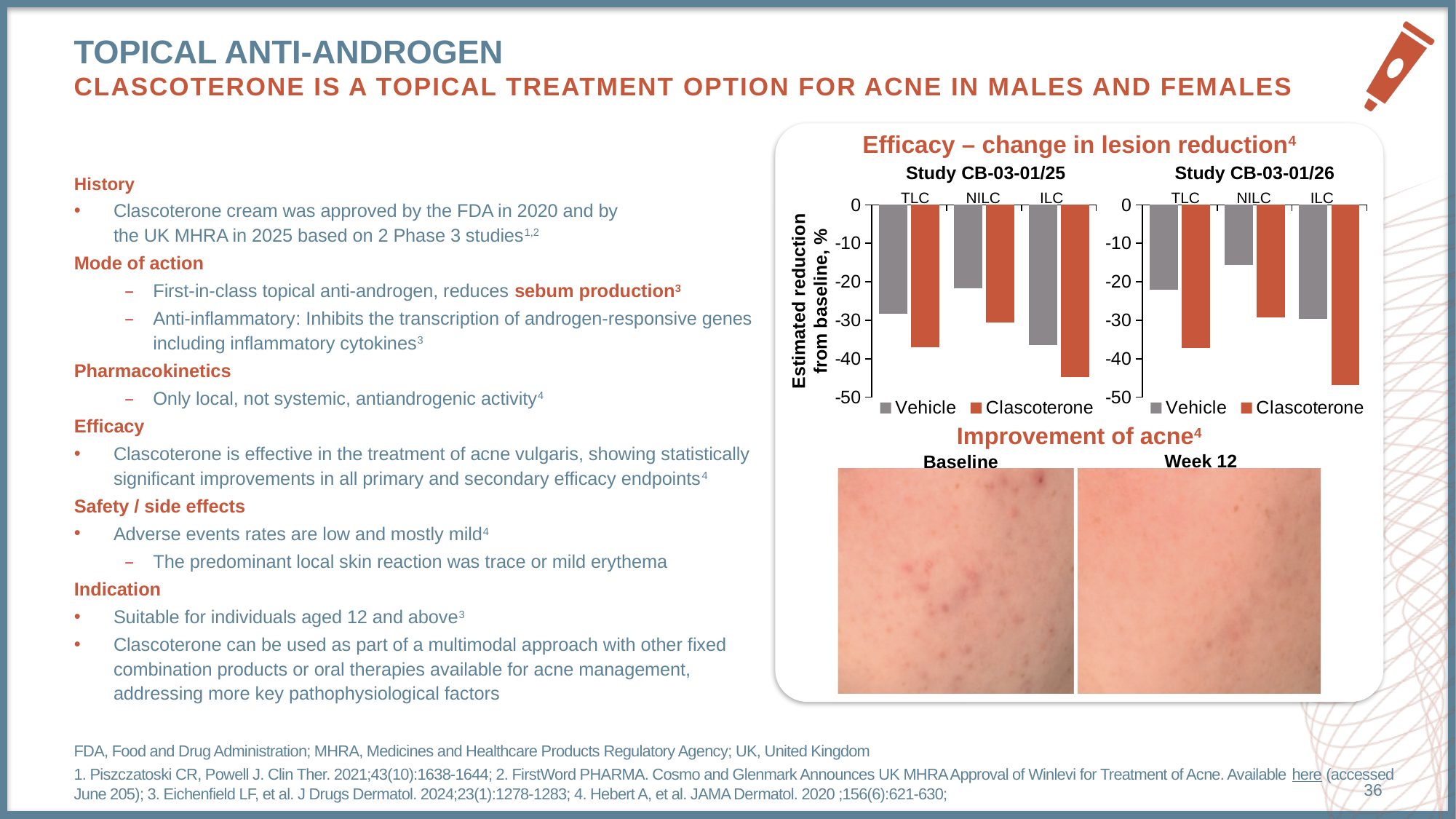
In the Study CB-03-01/25 chart, which category shows the smallest reduction from baseline for Clascoterone? NILC What type of chart is used for Study CB-03-01/25? bar chart In the Study CB-03-01/26 chart, is the value for Vehicle at NILC greater or less than -20? greater In the Study CB-03-01/26 chart, which series shows the larger reduction from baseline for ILC, Vehicle or Clascoterone? Clascoterone What is the y-axis label of the Study CB-03-01/25 chart? Estimated reduction from baseline, % In the Study CB-03-01/26 chart, which category shows the largest reduction from baseline for Clascoterone? ILC In the Study CB-03-01/26 chart, which category shows the smallest reduction from baseline for Vehicle? NILC In the Study CB-03-01/25 chart, which series shows the larger reduction from baseline for TLC, Vehicle or Clascoterone? Clascoterone In the Study CB-03-01/26 chart, is the value for Clascoterone at ILC greater or less than -40? less In the Study CB-03-01/25 chart, which series is shown in orange? Clascoterone In the Study CB-03-01/25 chart, how many series does the legend list? 2 In the Study CB-03-01/26 chart, how many categories are shown on the x axis? 3